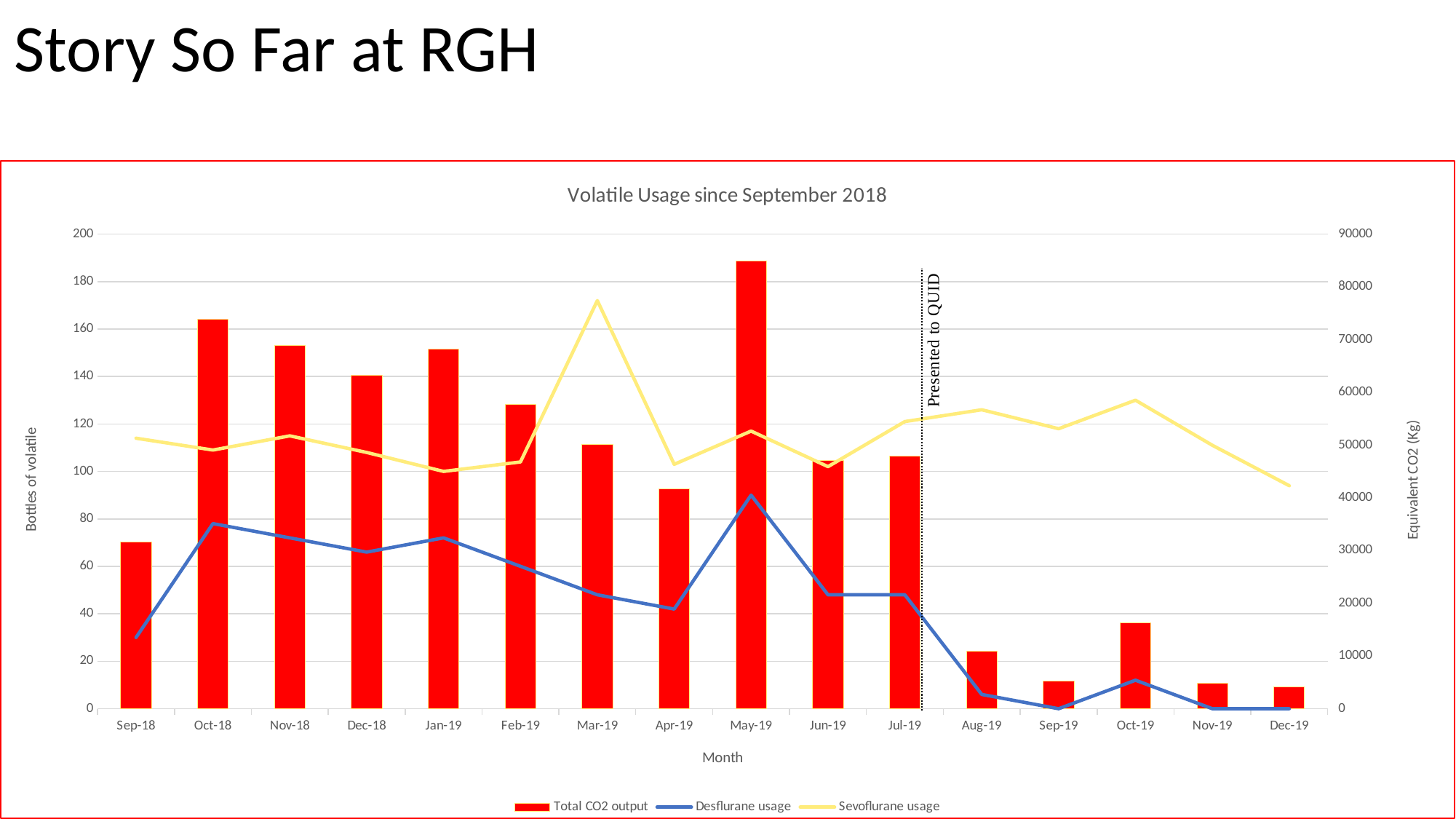
In which month does Sevoflurane usage reach its highest value? Mar-19 Does Desflurane usage rise or fall from Jul-19 to Aug-19? fall Is the Total CO2 output for Sep-19 greater or less than 10000 Kg? less In which month is the Total CO2 output bar highest? May-19 How many series does the legend list? 3 Is the Total CO2 output for May-19 greater or less than 80000 Kg? greater In which month is Sevoflurane usage lowest? Dec-19 Is the Desflurane usage for Sep-18 greater or less than 40 bottles? less What is the title of the chart? Volatile Usage since September 2018 How many months are shown on the x axis? 16 What kind of chart is shown on the slide? Combined bar and line chart Which is larger in Mar-19, Sevoflurane usage or Desflurane usage? Sevoflurane usage